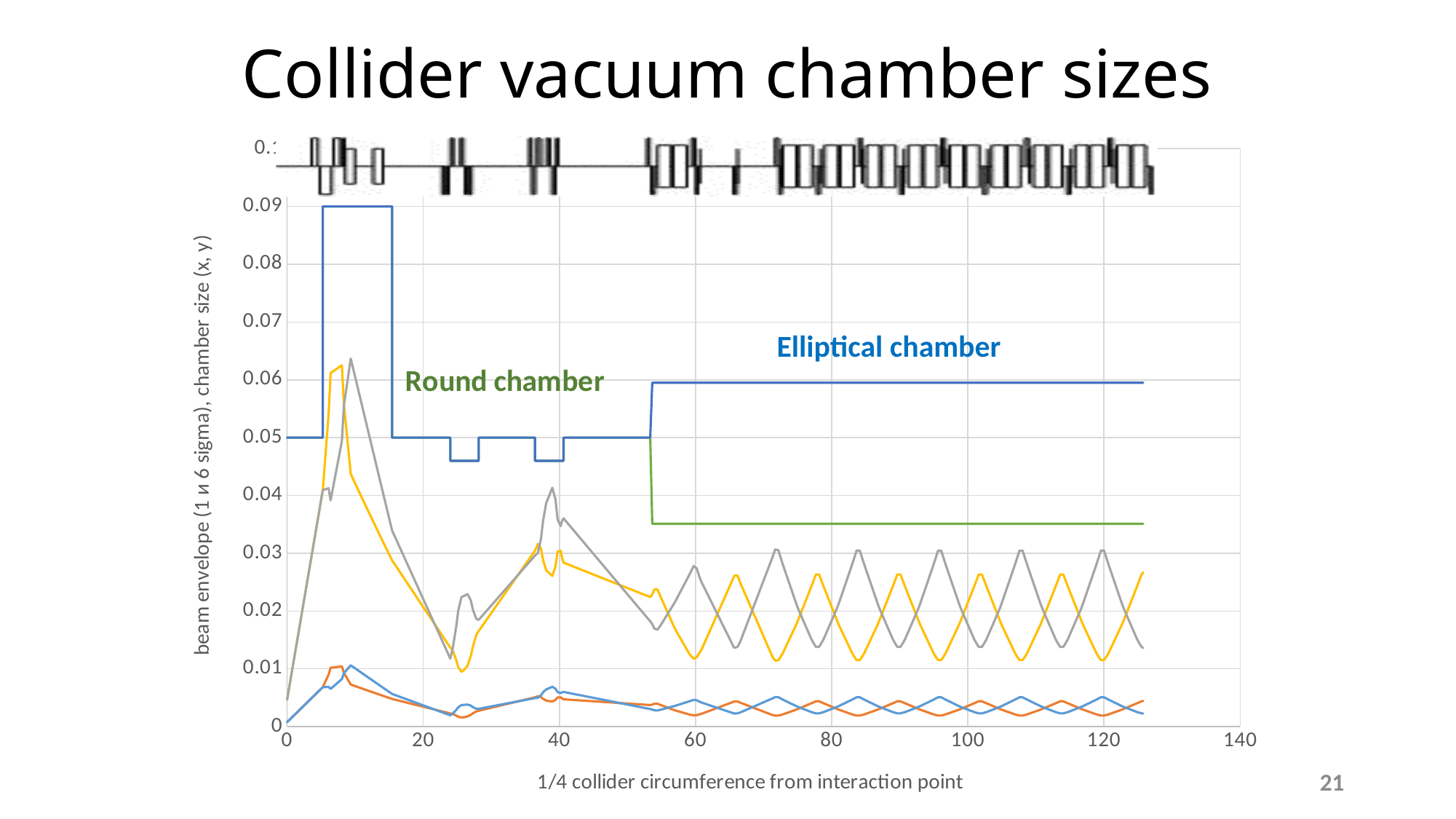
Is the peak of the gray line near x = 10 greater or less than 0.06? greater Is the value of the blue step line at x = 100 greater or less than 0.05? greater Does the gray line rise or fall between x = 10 and x = 24? fall What is the title of the x axis? 1/4 collider circumference from interaction point Is the lowest value of the yellow line near x = 60 greater or less than 0.02? less What are the two chamber types labelled on the chart? Round chamber and Elliptical chamber What kind of chart is shown on the slide? line chart What is the value of the blue step line at x = 20? 0.05 What is the highest value reached by the blue step line (chamber size)? 0.09 At x = 100, which is larger: the blue step line or the green line? the blue step line